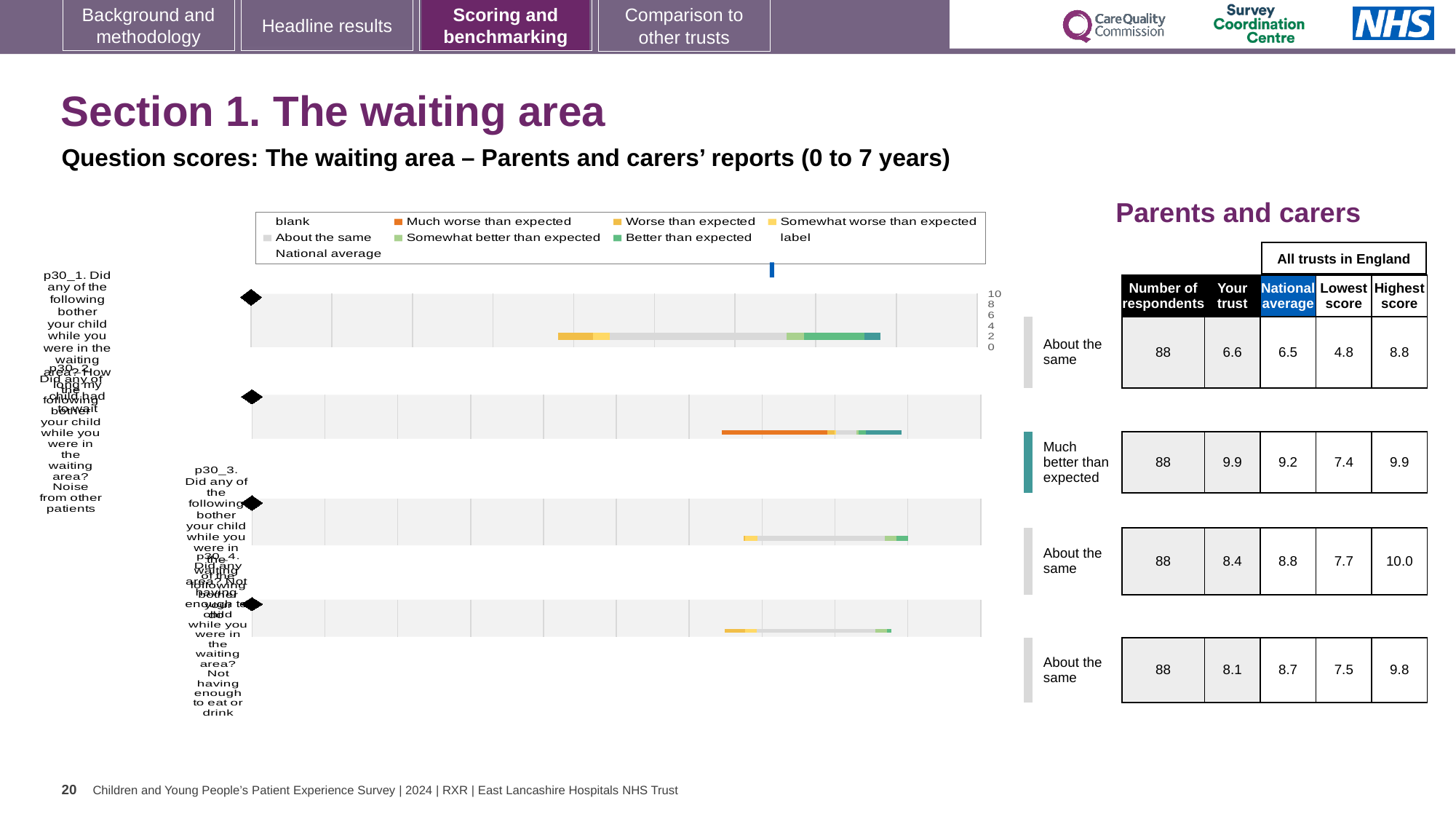
Which question row has the lowest 'Your trust' score in the table? p30_1 (first row) How many entries does the chart legend list? 9 What benchmark category is shown for the second question row (p30_2)? Much better than expected What is the difference between the 'Your trust' score and the national average for the second question row (p30_2)? 0.7 What benchmark category is shown for the first question row (p30_1)? About the same How many question rows (bars) does the chart show? 4 Which question row has the highest 'Your trust' score in the table? p30_2 (second row) For the third question row (p30_3), which is larger: the 'Your trust' score or the national average? National average In the table, what is the national average for the first question row (p30_1)? 6.5 What kind of chart is shown on the slide? bar chart What is the maximum value shown on the chart's score axis? 10 In the table, what is the 'Your trust' score for the second question row (p30_2)? 9.9